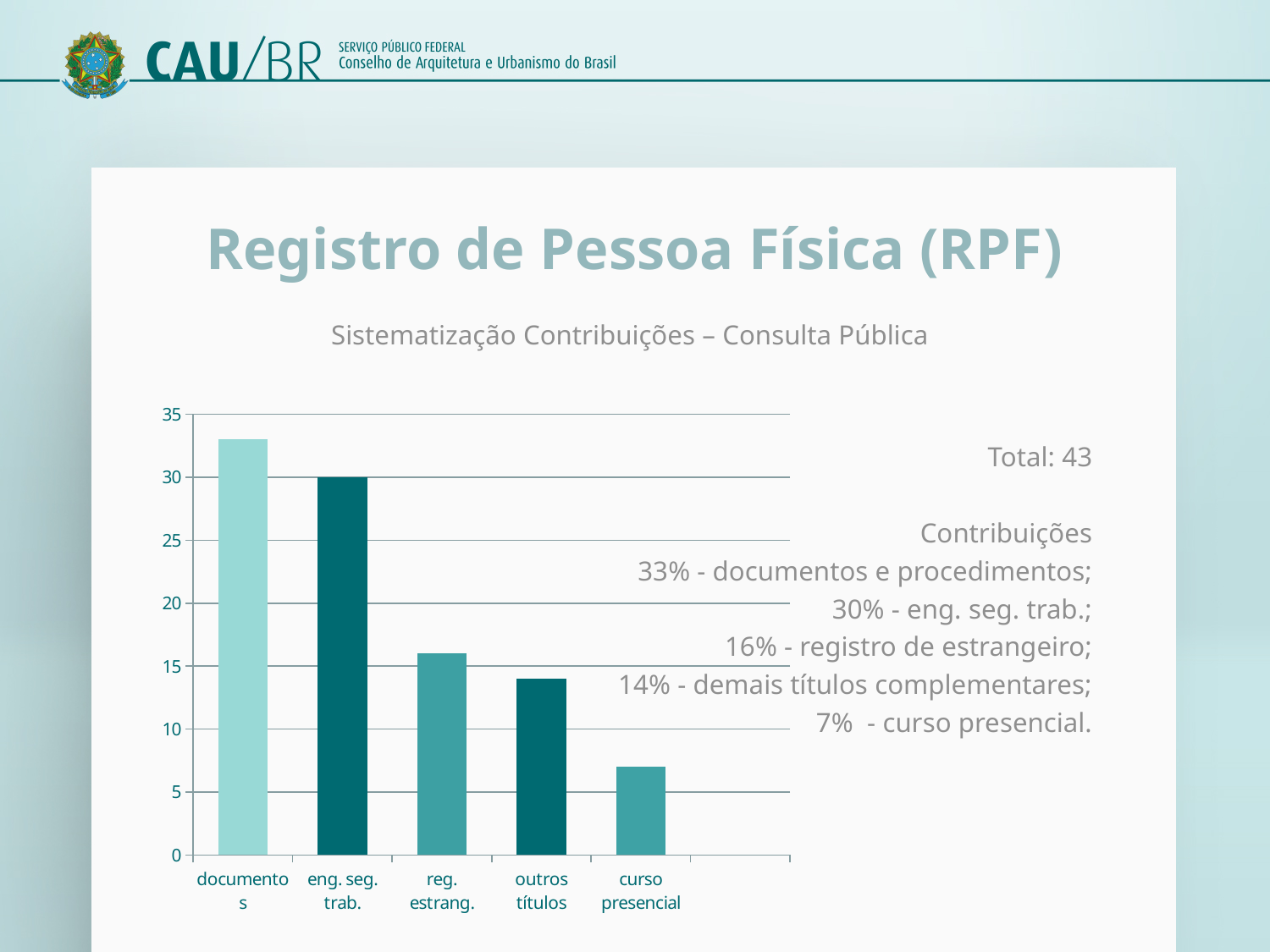
What type of chart is shown on the slide? bar chart What is the highest tick value shown on the y axis of the chart? 35 Which category has the lowest bar in the chart? curso presencial Which category has the highest bar in the chart? documentos Which is larger, the bar for reg. estrang. or the bar for curso presencial? reg. estrang. Is the value for documentos greater or less than 30? greater Do the bar values rise or fall from left to right along the x axis? fall How many categories are shown on the x axis of the chart? 5 What is the value of the bar for eng. seg. trab.? 30 Is the value for outros títulos greater or less than 15? less Is the value for reg. estrang. greater or less than 15? greater